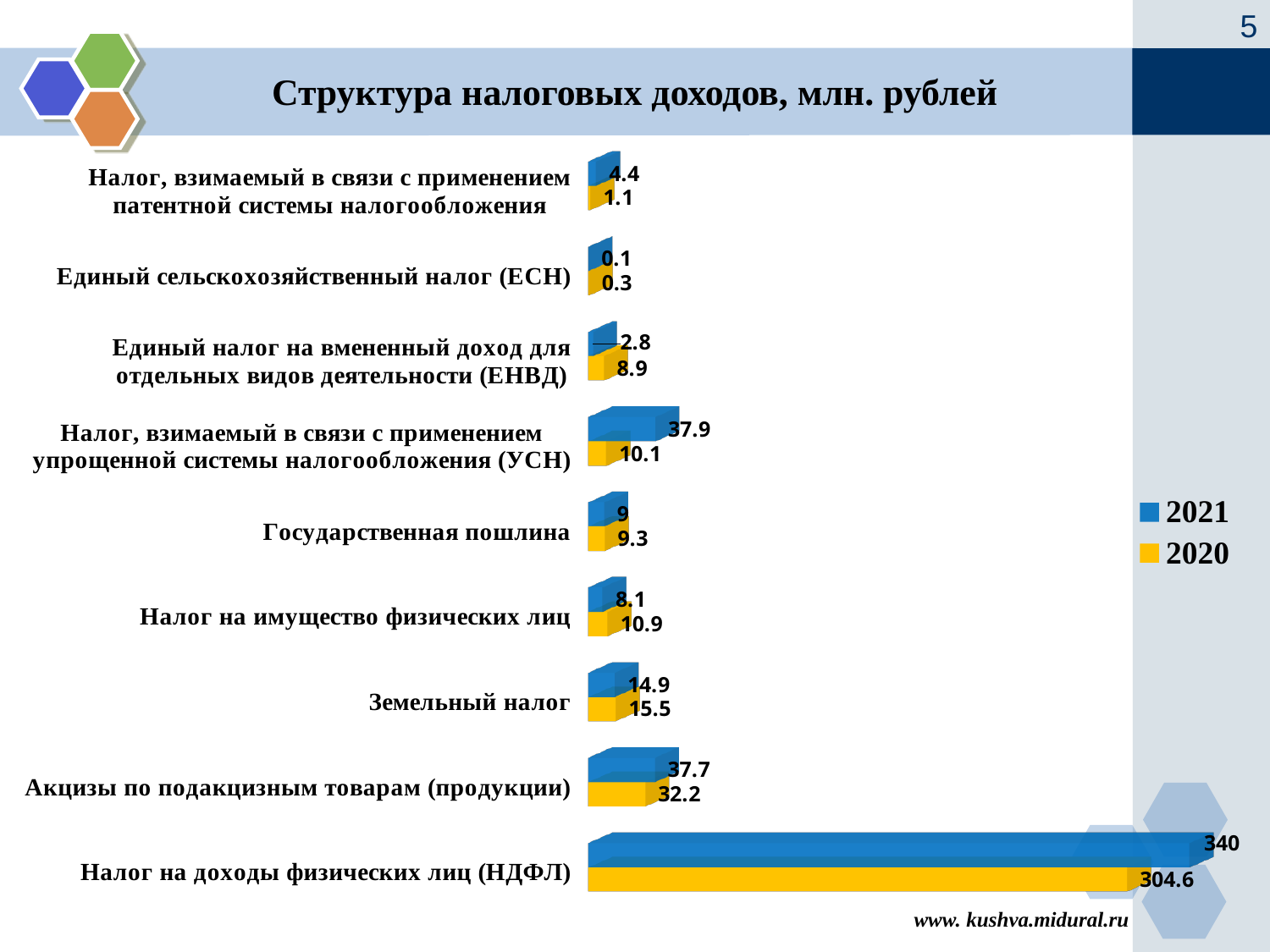
Which category has the lowest 2020 value? Единый сельскохозяйственный налог (ЕСН) What is the title of the chart? Структура налоговых доходов, млн. рублей What is the 2020 value for Акцизы по подакцизным товарам (продукции)? 32.2 What is the difference between the 2021 and 2020 values for Налог на доходы физических лиц (НДФЛ)? 35.4 What type of chart is shown on the slide? bar chart For Единый налог на вмененный доход (ЕНВД), which year has the larger value, 2021 or 2020? 2020 How many tax categories are shown in the chart? 9 What is the 2021 value for Налог на доходы физических лиц (НДФЛ)? 340 What is the difference between the 2021 and 2020 values for Земельный налог? 0.6 What is the 2021 value for Налог, взимаемый в связи с применением упрощенной системы налогообложения (УСН)? 37.9 Which category has the highest 2021 value? Налог на доходы физических лиц (НДФЛ) How many series does the legend list? 2